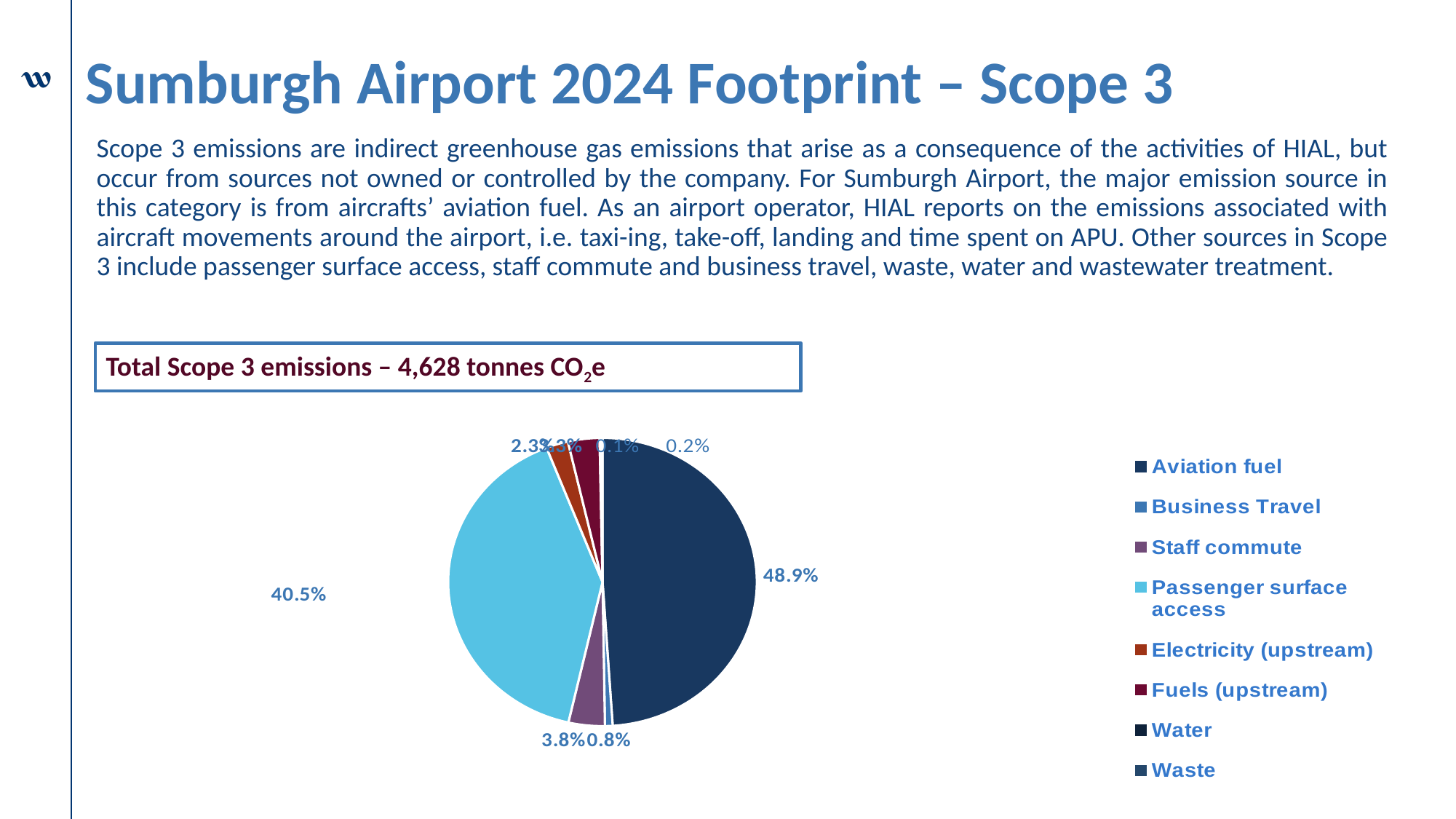
Which category accounts for the largest share of the pie? Aviation fuel What share of Scope 3 emissions comes from Waste? 0.2% What share of Scope 3 emissions comes from Aviation fuel? 48.9% What type of chart is shown on the slide? Pie chart What share of Scope 3 emissions comes from Business Travel? 0.8% What share of Scope 3 emissions comes from Passenger surface access? 40.5% Which category accounts for the smallest share of the pie? Water What share of Scope 3 emissions comes from Staff commute? 3.8% What is the difference in percentage points between the Aviation fuel share and the Passenger surface access share? 8.4 percentage points What total Scope 3 emissions figure is stated above the chart? 4,628 tonnes CO2e What share of Scope 3 emissions comes from Electricity (upstream)? 2.3% How many categories does the legend of the pie chart list? 8